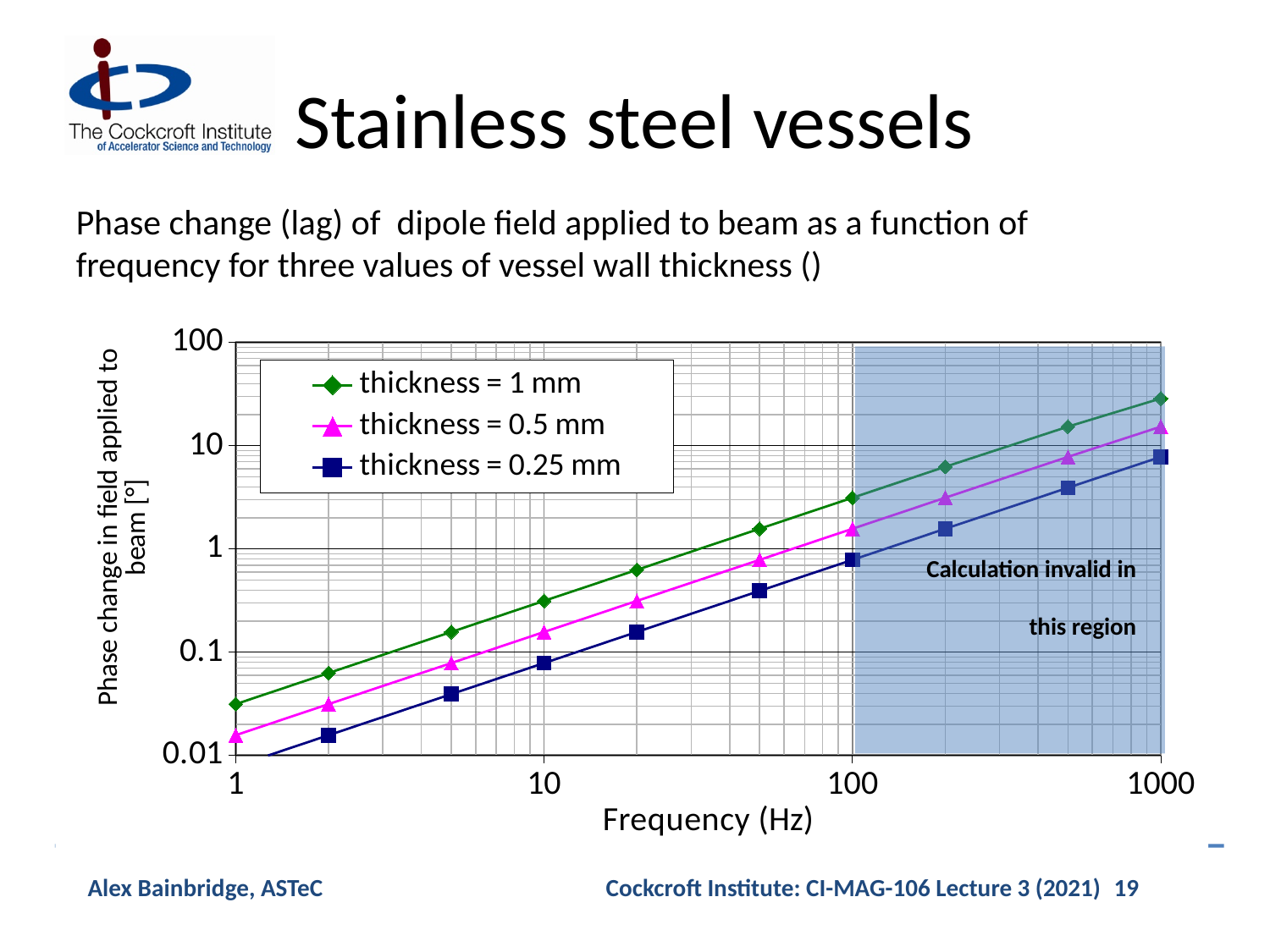
How many data points are plotted for the thickness = 1 mm series? 10 What are the three series named in the legend? thickness = 1 mm, thickness = 0.5 mm, thickness = 0.25 mm Which thickness series has the lowest phase change at 10 Hz? thickness = 0.25 mm How many series does the legend list? 3 What text is written in the shaded region of the chart? Calculation invalid in this region Is the phase change for thickness = 1 mm at 100 Hz greater or less than 1? greater What kind of chart is shown on the slide? line chart Is the phase change for thickness = 1 mm at 1000 Hz greater or less than 10? greater Is the phase change for thickness = 0.25 mm at 10 Hz greater or less than 0.1? less Which thickness series has the highest phase change at 1000 Hz? thickness = 1 mm At 100 Hz, which is larger: the phase change for thickness = 1 mm or for thickness = 0.25 mm? thickness = 1 mm Does the phase change rise or fall as frequency increases? rise